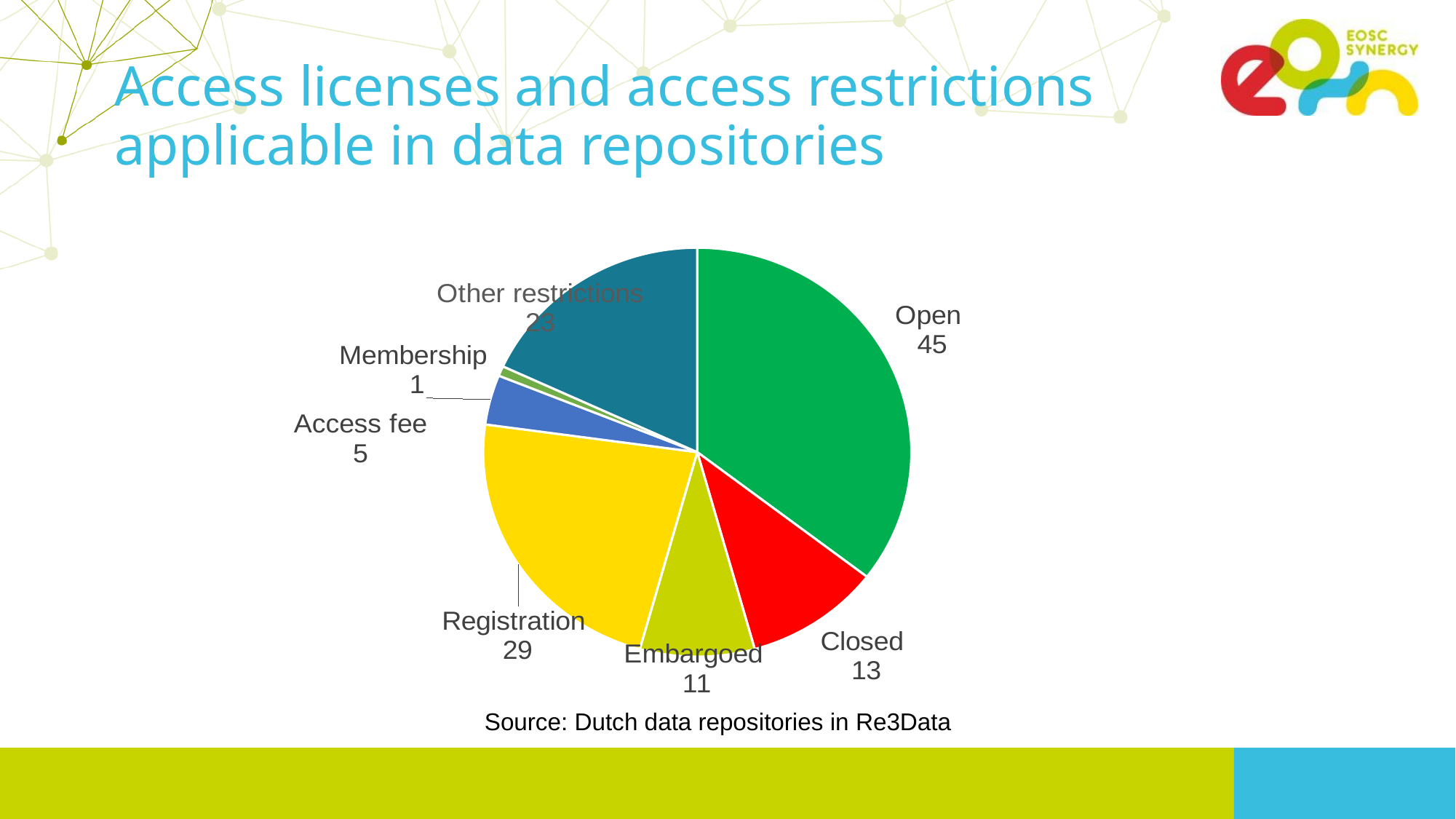
What is the value for Registration? 29 Which is larger, Closed or Embargoed? Closed Which category has the largest slice? Open How many categories are shown in the pie chart? 7 What is the difference between the values for Closed and Access fee? 8 What is the value for Embargoed? 11 What type of chart is shown on the slide? pie chart Which category has the smallest slice? Membership What is the value for Open? 45 What is the value for Other restrictions? 23 What is the difference between the values for Open and Registration? 16 What source is cited below the chart? Dutch data repositories in Re3Data